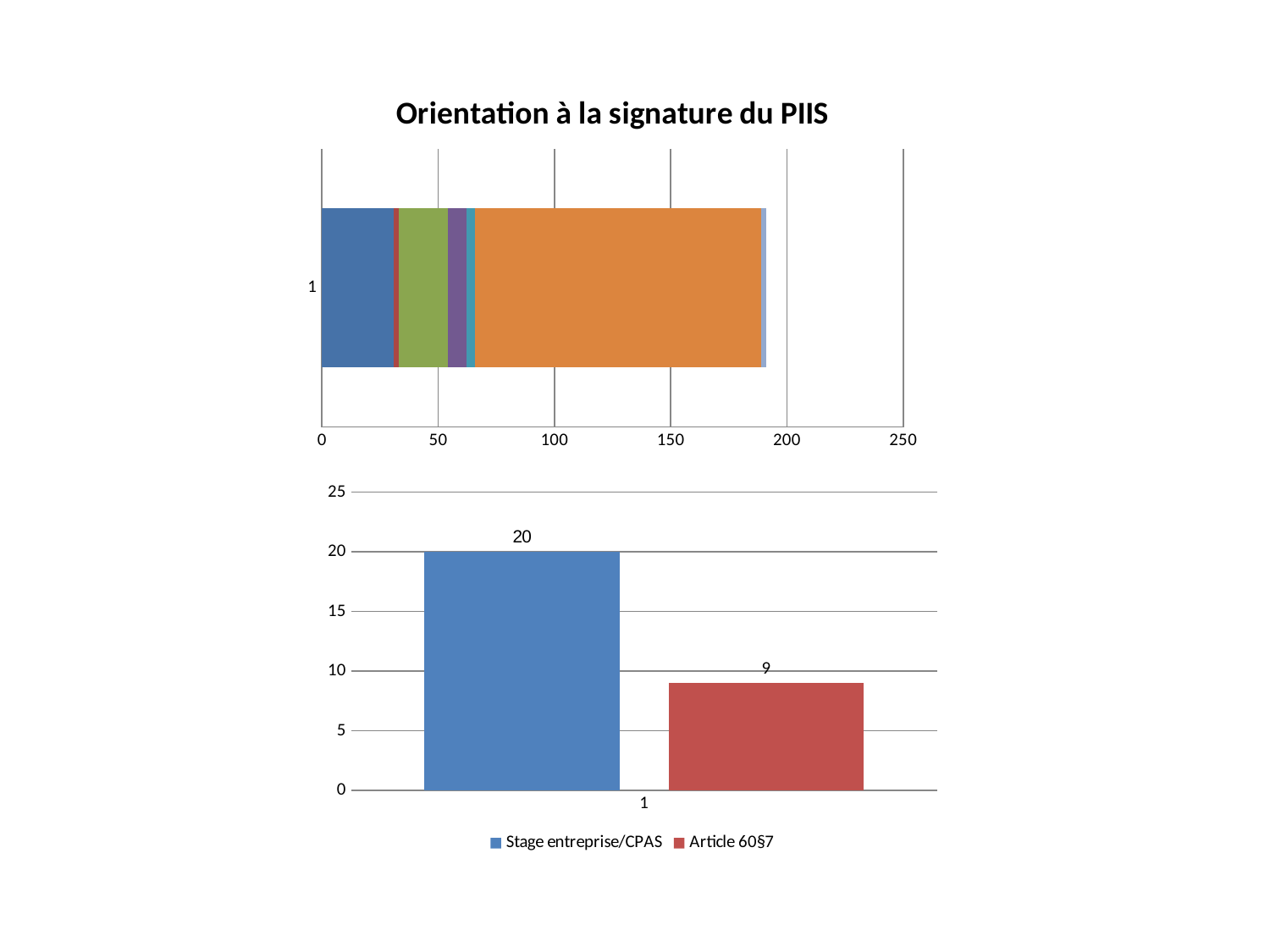
What kind of chart is the chart titled 'Orientation à la signature du PIIS'? Stacked bar chart What kind of chart is the bottom chart? Bar chart In the bottom chart, what is the difference between the values for Stage entreprise/CPAS and Article 60§7? 11 In the bottom chart, which series has the highest value? Stage entreprise/CPAS In the bottom chart, is the value for Article 60§7 greater or less than 10? less In the bottom chart, which is larger: Stage entreprise/CPAS or Article 60§7? Stage entreprise/CPAS What is the title of the top chart? Orientation à la signature du PIIS How many series does the legend of the bottom chart list? 2 In the chart titled 'Orientation à la signature du PIIS', is the total length of the stacked bar greater or less than 200? less In the bottom chart, what is the value for Stage entreprise/CPAS? 20 In the bottom chart, what is the value for Article 60§7? 9 In the bottom chart, which series has the lowest value? Article 60§7